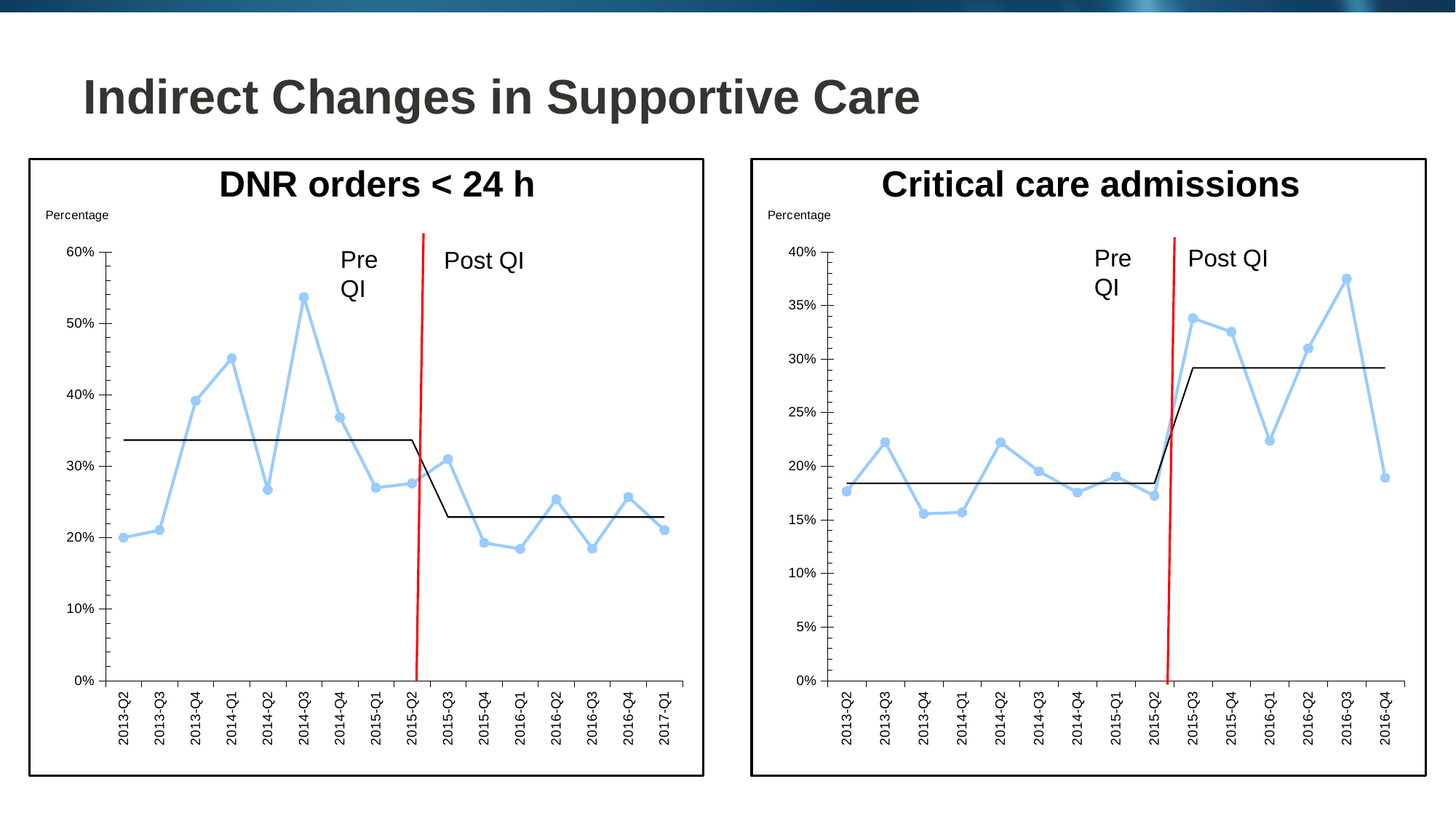
In the "Critical care admissions" chart, which is larger, the value for 2015-Q3 or the value for 2013-Q3? 2015-Q3 How many quarters are plotted on the x axis of the "Critical care admissions" chart? 15 What label is shown on the vertical axis of the "Critical care admissions" chart? Percentage In the "Critical care admissions" chart, is the value for 2013-Q2 greater or less than 20%? less In the "DNR orders < 24 h" chart, is the value for 2014-Q3 greater or less than 50%? greater In the "DNR orders < 24 h" chart, is the value for 2016-Q1 greater or less than 20%? less How many quarters are plotted on the x axis of the "DNR orders < 24 h" chart? 16 In the "DNR orders < 24 h" chart, which quarter has the highest value? 2014-Q3 In the "Critical care admissions" chart, which quarter has the highest value? 2016-Q3 What kind of chart is the "DNR orders < 24 h" chart? line chart In the "DNR orders < 24 h" chart, which is larger, the value for 2014-Q1 or the value for 2015-Q3? 2014-Q1